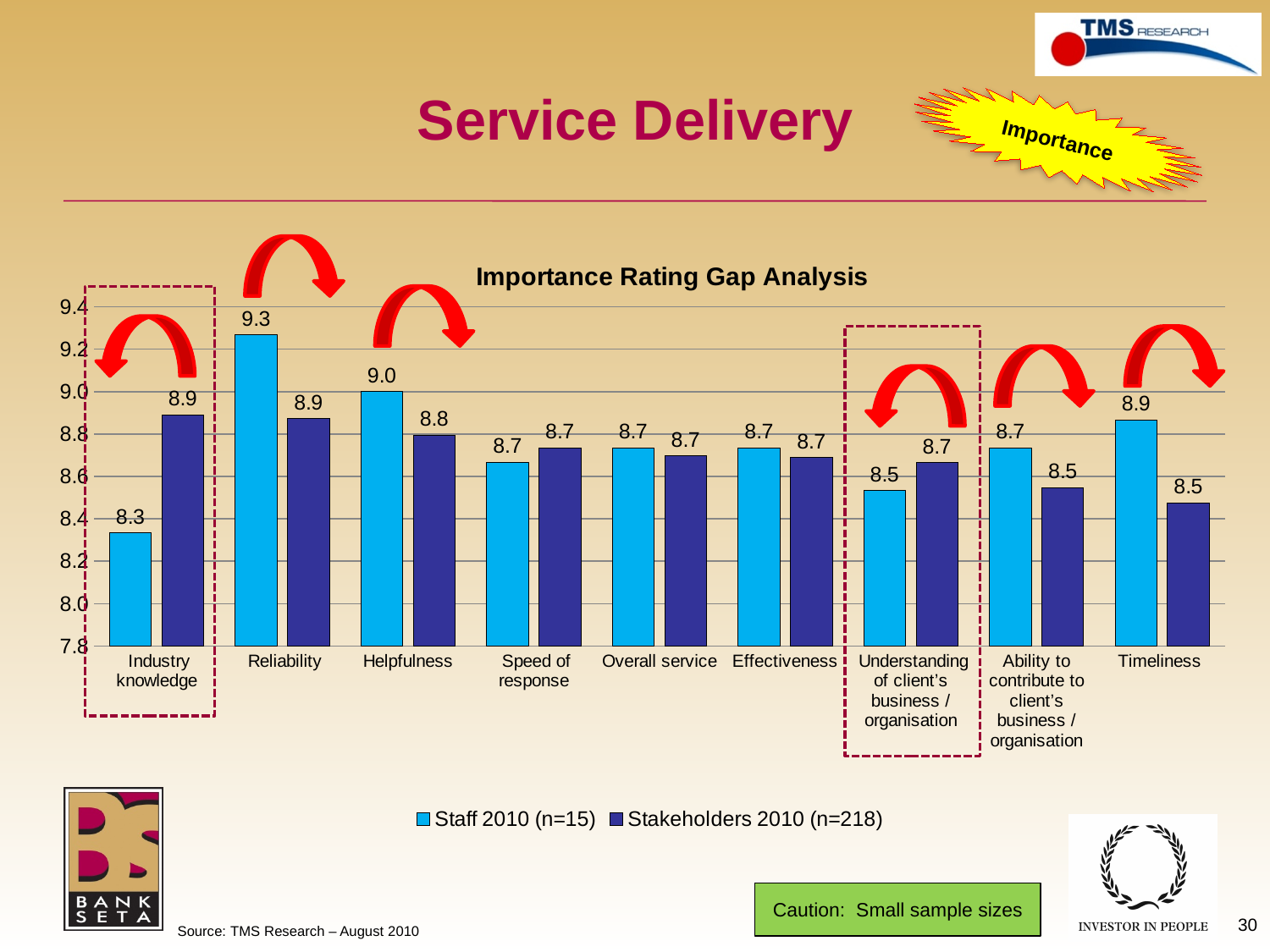
What is the difference between the Staff 2010 and Stakeholders 2010 ratings for Reliability? 0.4 For Timeliness, which series has the higher rating, Staff 2010 or Stakeholders 2010? Staff 2010 What is the difference between the Stakeholders 2010 and Staff 2010 ratings for Industry knowledge? 0.6 What is the Staff 2010 importance rating for Reliability? 9.3 What is the Stakeholders 2010 importance rating for Industry knowledge? 8.9 Which category has the highest Staff 2010 rating? Reliability How many categories are shown on the x axis of the chart? 9 What is the Staff 2010 rating for Understanding of client's business / organisation? 8.5 Is the Staff 2010 rating for Reliability greater or less than 9.0? greater What is the Stakeholders 2010 rating for Timeliness? 8.5 Which category has the lowest Staff 2010 rating? Industry knowledge How many series does the chart legend list? 2